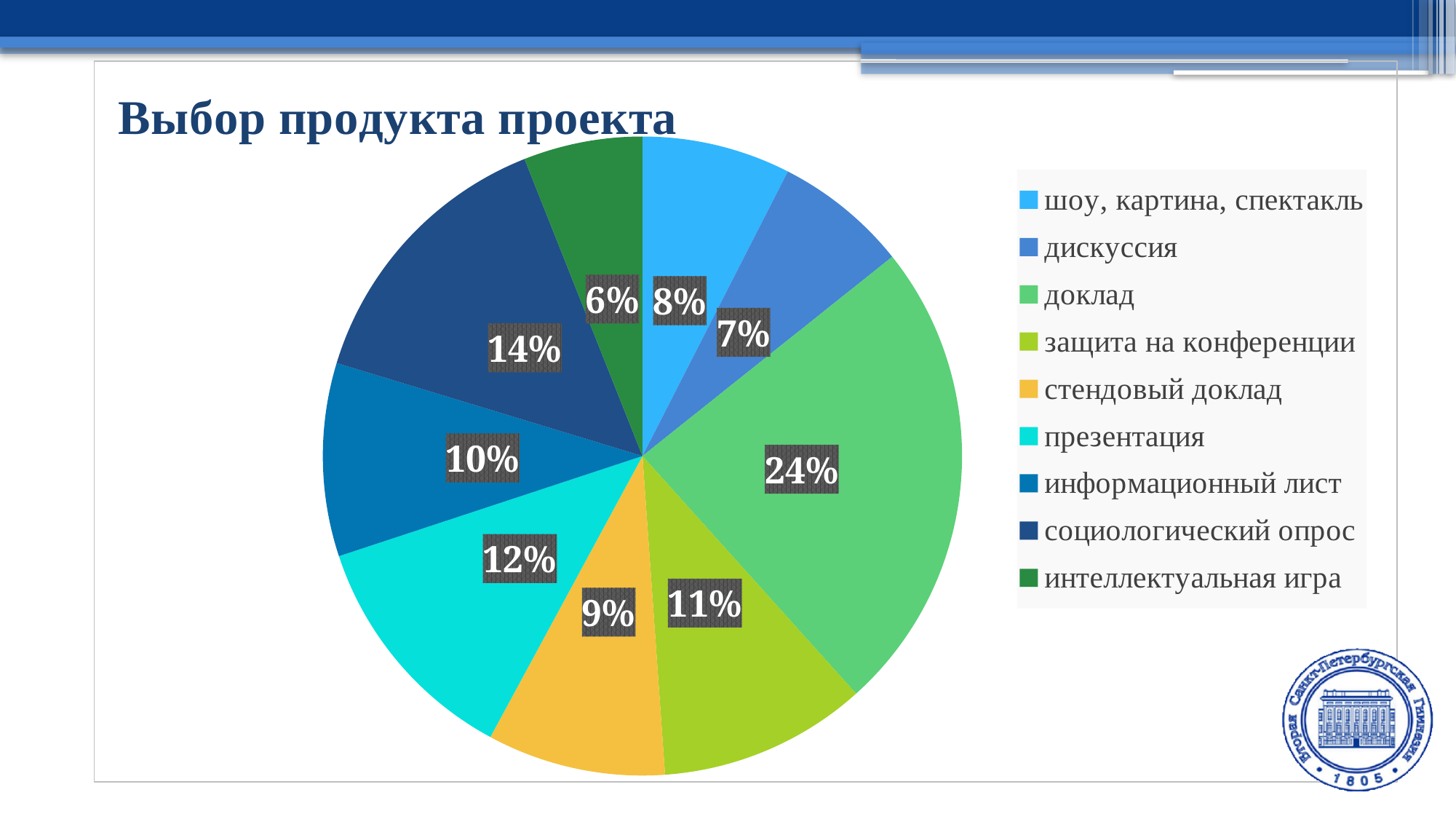
What is the value shown for "стендовый доклад"? 9% How many slices does the pie chart have? 9 What is the value shown for "презентация"? 12% What is the title of the chart? Выбор продукта проекта What share of the pie does "доклад" have? 24% What is the value shown for "социологический опрос"? 14% Which category has the smallest share of the pie? интеллектуальная игра Which is larger: the share for "защита на конференции" or the share for "информационный лист"? защита на конференции What is the value shown for "дискуссия"? 7% Which category has the largest share of the pie? доклад What is the difference between the shares of "доклад" and "социологический опрос"? 10% What kind of chart is shown on the slide? pie chart